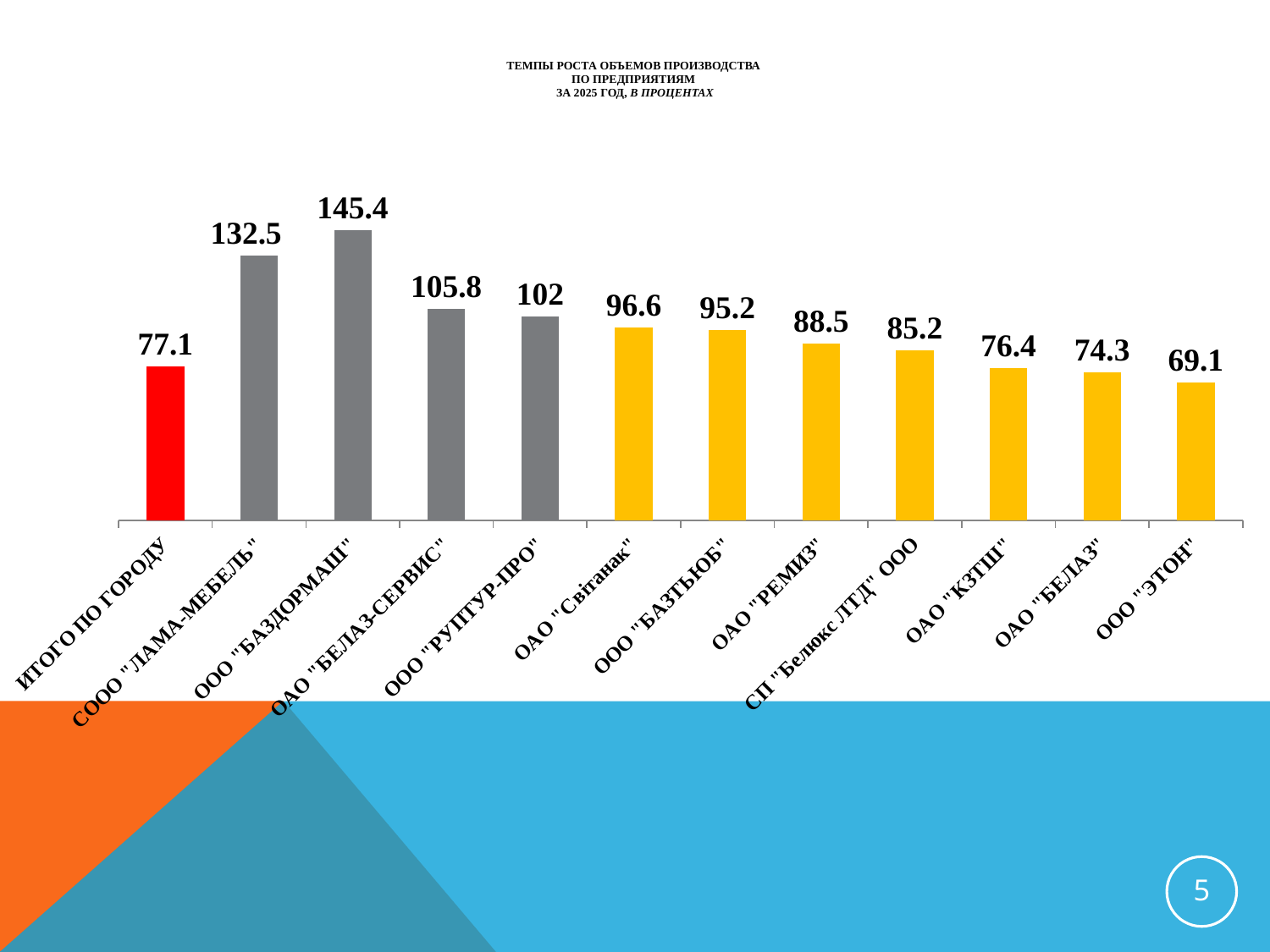
Which is larger, the value for ОАО "БЕЛАЗ-СЕРВИС" or the value for ОАО "РЕМИЗ"? ОАО "БЕЛАЗ-СЕРВИС" What is the difference between the values for ООО "БАЗДОРМАШ" and СООО "ЛАМА-МЕБЕЛЬ"? 12.9 Which category has the highest value? ООО "БАЗДОРМАШ" What is the value for ИТОГО ПО ГОРОДУ? 77.1 How many categories are shown on the chart? 12 What is the value for ООО "РУПТУР-ПРО"? 102 What kind of chart is shown on the slide? Bar chart Which category has the lowest value? ООО "ЭТОН" What is the difference between the values for ОАО "Світанак" and ООО "ЭТОН"? 27.5 What year does the chart title say the data is for? 2025 What is the value for СП "Белюкс ЛТД" ООО? 85.2 What colour is the bar for ИТОГО ПО ГОРОДУ? Red